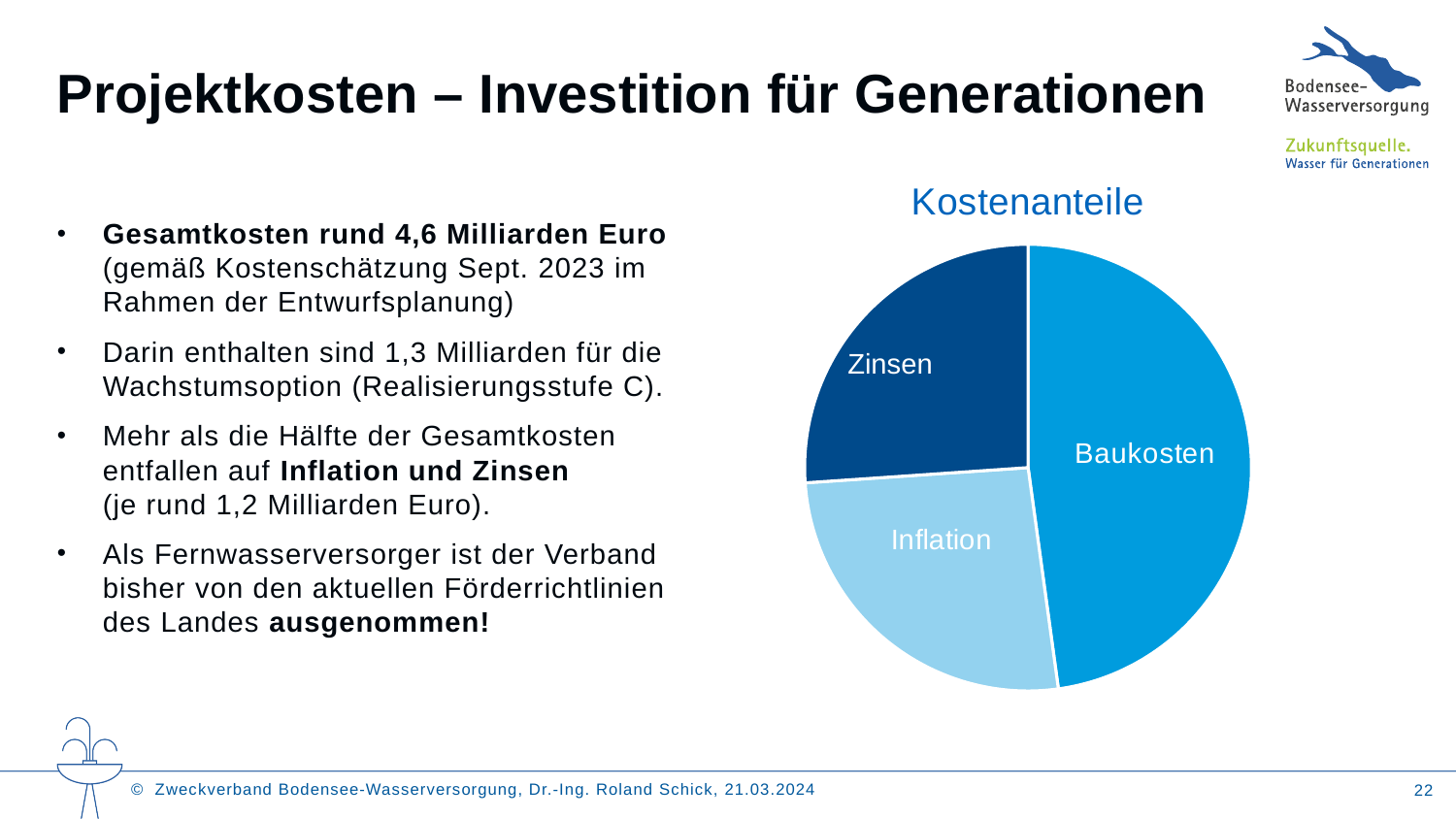
What is the title of the chart? Kostenanteile Which is larger in the pie chart, Baukosten or Zinsen? Baukosten What are the labels of the three slices in the pie chart? Baukosten, Zinsen, Inflation What kind of chart is shown on the slide? pie chart Which slice of the pie chart is the largest? Baukosten Which slice of the pie chart is shown in the darkest blue? Zinsen How many slices does the pie chart have? 3 Which is larger in the pie chart, Baukosten or Inflation? Baukosten